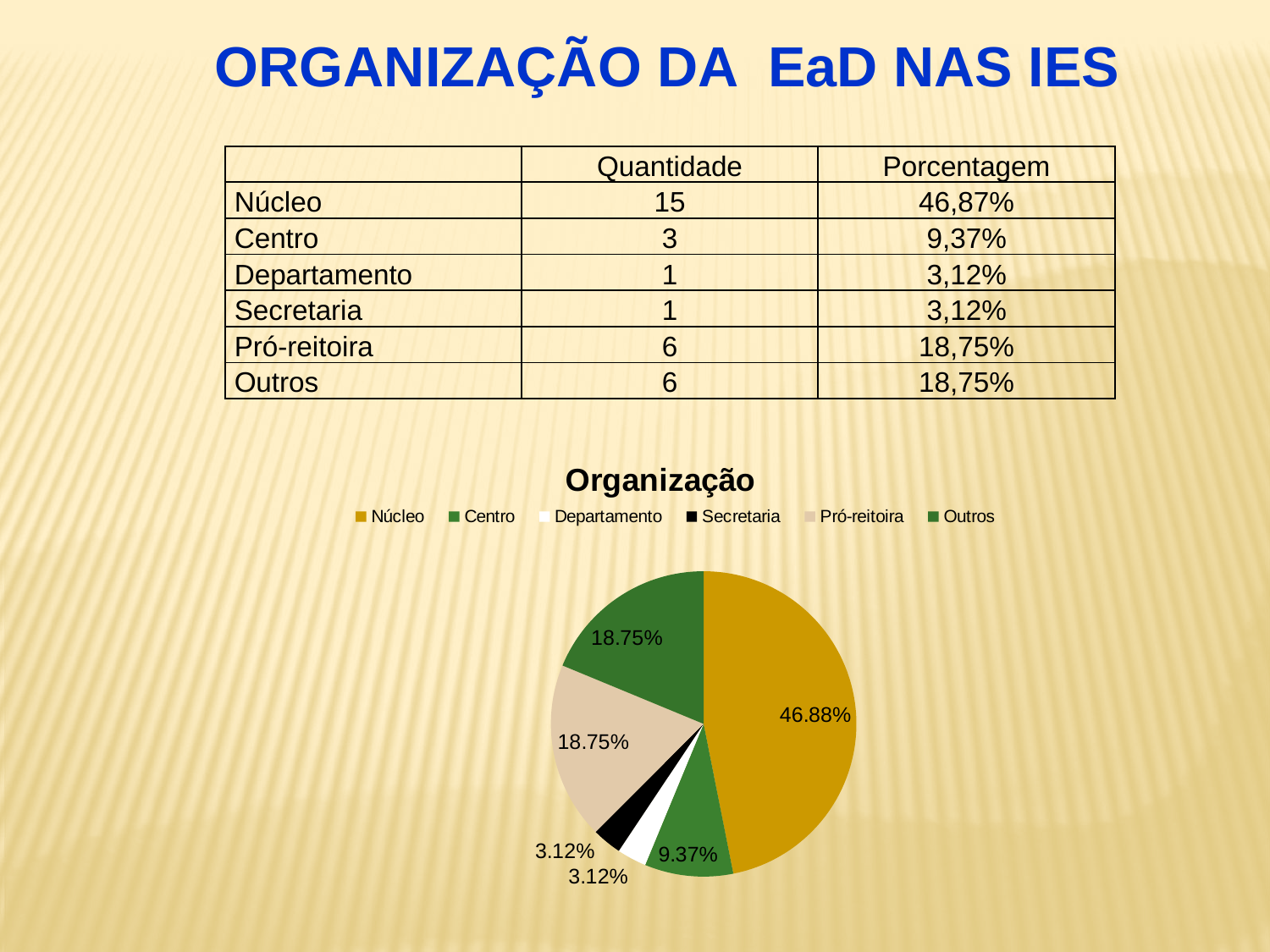
What kind of chart is shown under the title "Organização"? pie chart In the "Organização" pie chart, which slice is larger, Centro or Outros? Outros How many entries does the legend of the "Organização" pie chart list? 6 In the "Organização" pie chart, what share does the Centro slice have? 9.37% In the "Organização" pie chart, what share does the Pró-reitoira slice have? 18.75% In the "Organização" pie chart, what is the difference between the Núcleo share and the Centro share? 37.51% In the "Organização" pie chart, what share does the Núcleo slice have? 46.88% How many slices does the "Organização" pie chart have? 6 In the "Organização" pie chart, what is the difference between the Outros share and the Secretaria share? 15.63% In the "Organização" pie chart, what share does the Departamento slice have? 3.12% What is the title of the pie chart on the slide? Organização Which category has the largest slice in the "Organização" pie chart? Núcleo